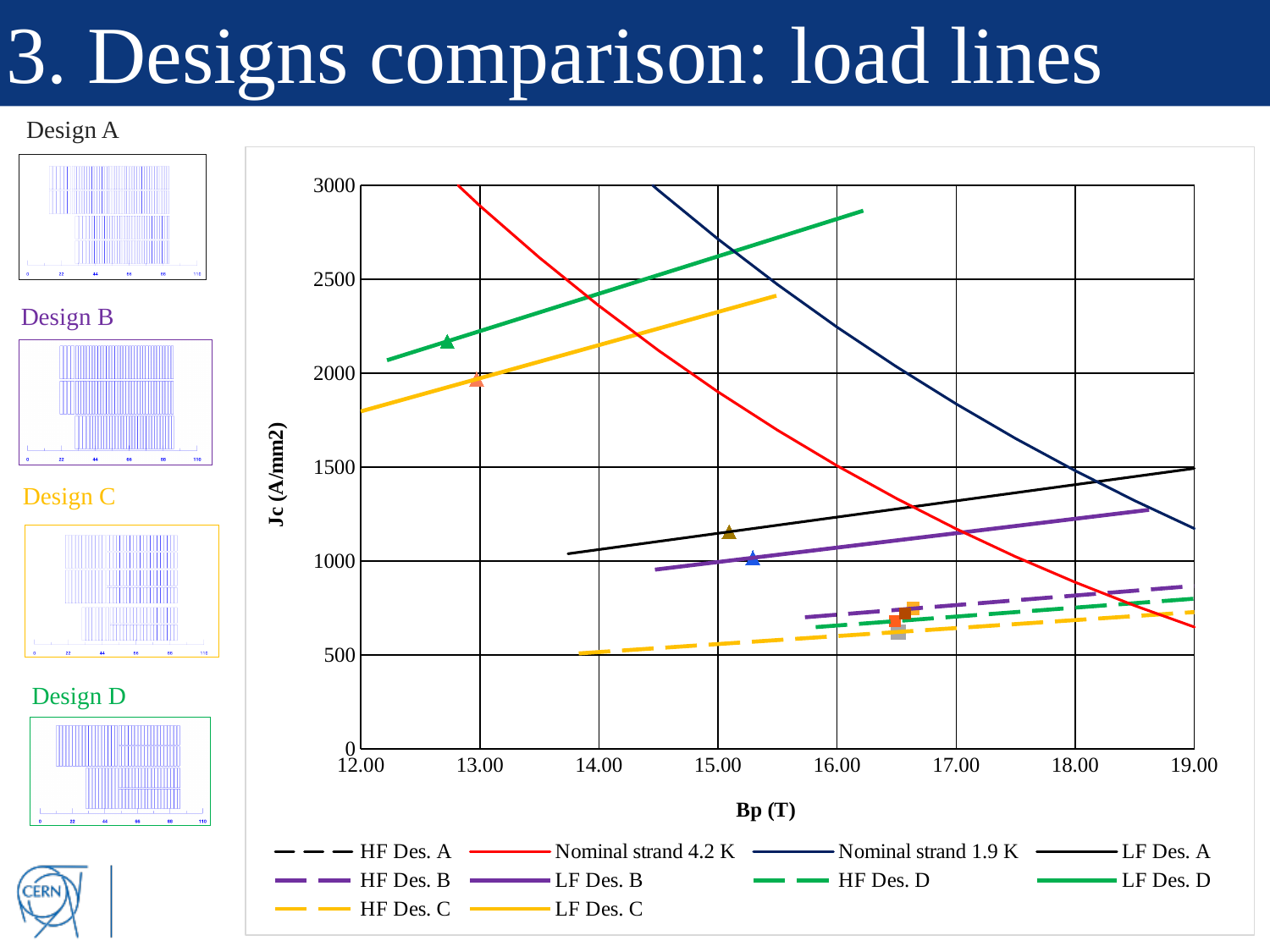
What kind of chart is shown on the slide? line chart Is the value of LF Des. D at Bp = 13.00 greater or less than 2000? greater Is the value of HF Des. C at Bp = 16.00 greater or less than 500? greater At Bp = 16.00, which is higher: LF Des. A or LF Des. B? LF Des. A Is the value of Nominal strand 1.9 K at Bp = 17.00 greater or less than 2000? less What is the label of the x axis of the chart? Bp (T) How many series does the chart legend list? 10 What is the label of the y axis of the chart? Jc (A/mm2) Does the Nominal strand 4.2 K curve rise or fall as Bp increases? fall Does the LF Des. D line rise or fall as Bp increases? rise At Bp = 16.00, which series has the highest Jc value? LF Des. D